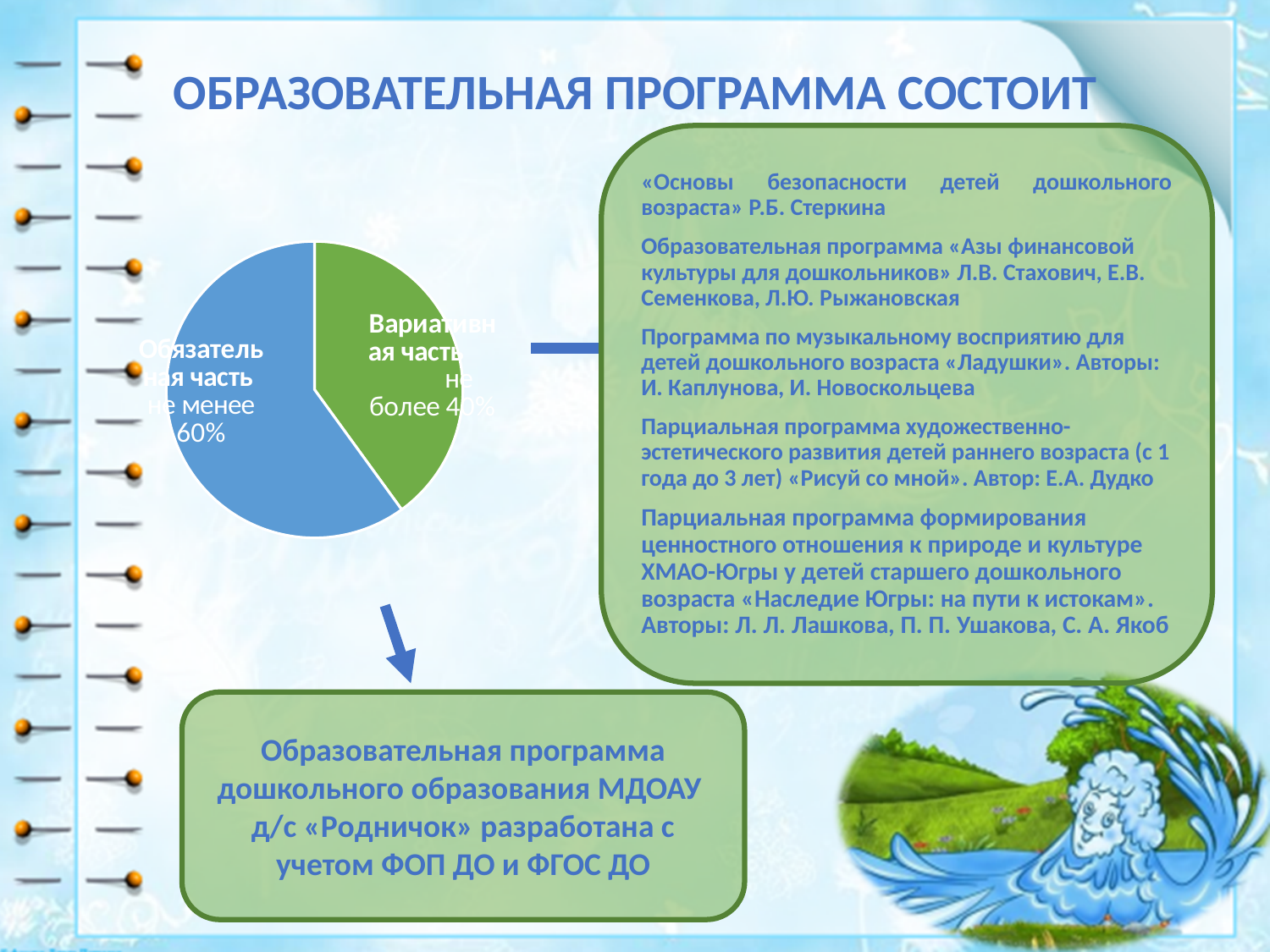
How many slices does the pie chart have? 2 What share of the pie does the Обязательная часть slice represent? 60% What is the difference in percentage points between the Обязательная часть slice (60%) and the Вариативная часть slice (40%)? 20% What share of the pie does the Вариативная часть slice represent? 40% What value is printed for the slice "Вариативная часть" in the pie chart? не более 40% Which slice of the pie chart is the largest? Обязательная часть What colour is the Обязательная часть slice in the pie chart? blue What value is printed for the slice "Обязательная часть" in the pie chart? не менее 60% What colour is the Вариативная часть slice in the pie chart? green Which slice of the pie chart is the smallest? Вариативная часть What type of chart is shown on the slide? pie chart Which is larger in the pie chart: Обязательная часть or Вариативная часть? Обязательная часть